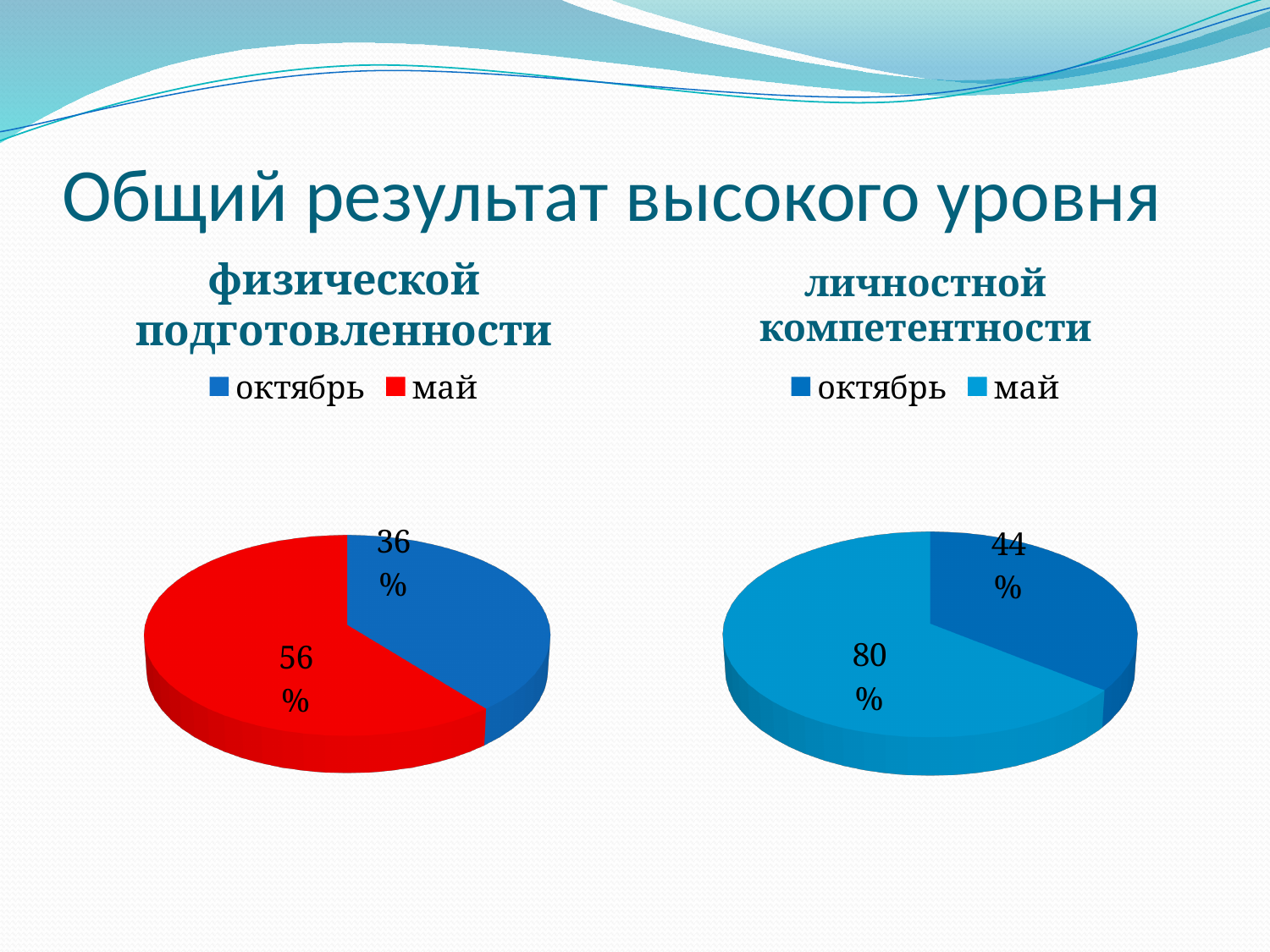
In the chart titled 'физической подготовленности', what colour is the май slice? Red In the chart titled 'физической подготовленности', what value is shown for октябрь? 36% How many series does the legend of the chart titled 'личностной компетентности' list? 2 In the chart titled 'личностной компетентности', what value is shown for май? 80% In the chart titled 'личностной компетентности', what value is shown for октябрь? 44% What type of chart is the one on the left of the slide? Pie chart In the chart titled 'физической подготовленности', which slice is larger, октябрь or май? май In the chart titled 'физической подготовленности', what is the difference between the май and октябрь values? 20% In the chart titled 'личностной компетентности', what is the difference between the май and октябрь values? 36% In the chart titled 'личностной компетентности', which slice is the largest? май In the chart titled 'физической подготовленности', what value is shown for май? 56% In the chart titled 'личностной компетентности', which slice is the smallest? октябрь